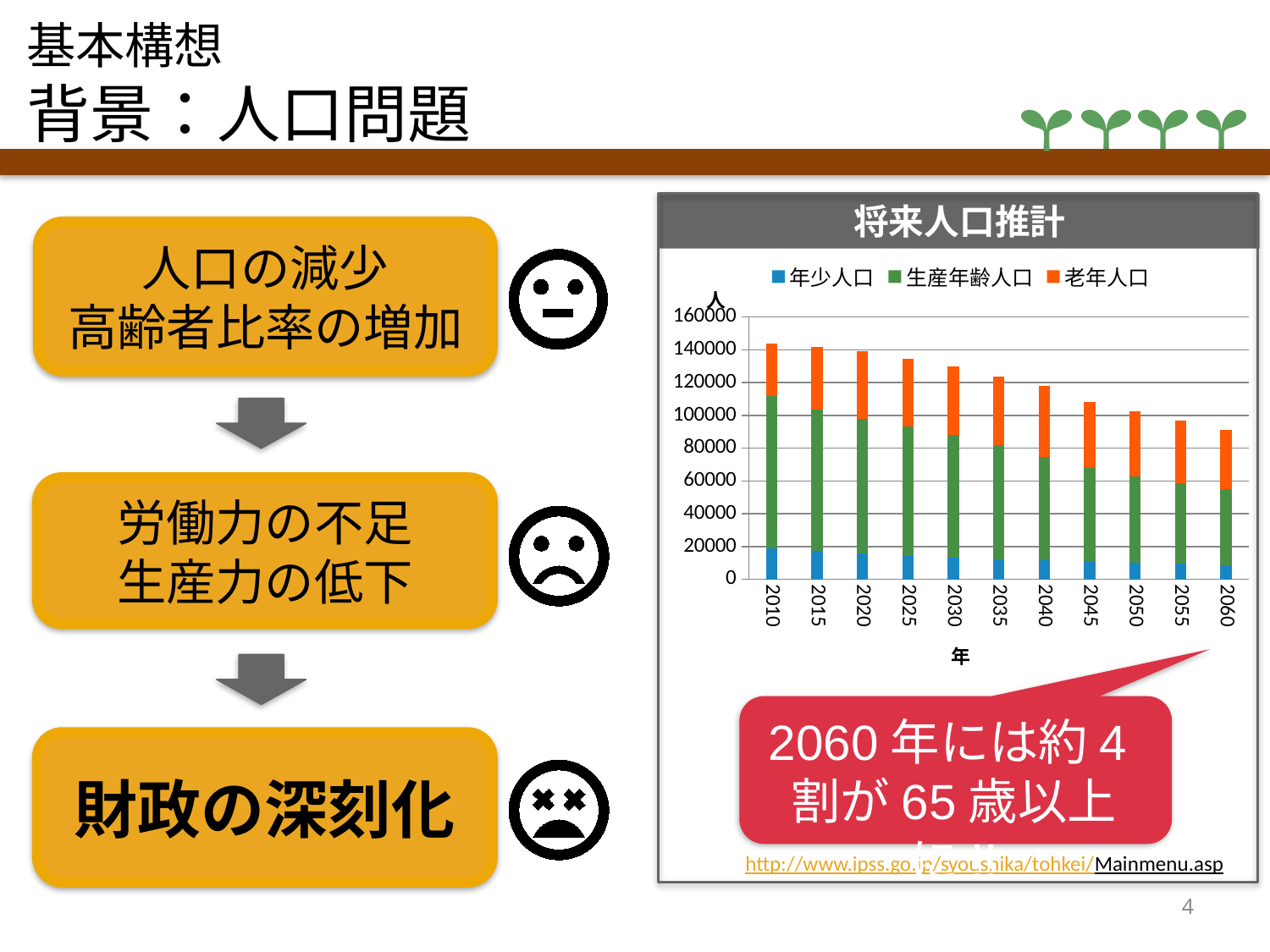
Which year has the larger total bar, 2010 or 2060? 2010 Which year has the tallest stacked bar in the 将来人口推計 chart? 2010 Is the total bar height for 2045 greater or less than 120000? less Which series is shown in orange in the 将来人口推計 chart? 老年人口 How many years are plotted along the x axis of the 将来人口推計 chart? 11 Which year has the shortest stacked bar in the 将来人口推計 chart? 2060 What is the title of the chart on the slide? 将来人口推計 Do the total bar heights rise or fall from 2010 to 2060 in the 将来人口推計 chart? fall Is the total bar height for 2060 greater or less than 100000? less What kind of chart is shown under the title 将来人口推計? stacked bar chart Is the total bar height for 2025 greater or less than 120000? greater How many series does the legend of the 将来人口推計 chart list? 3